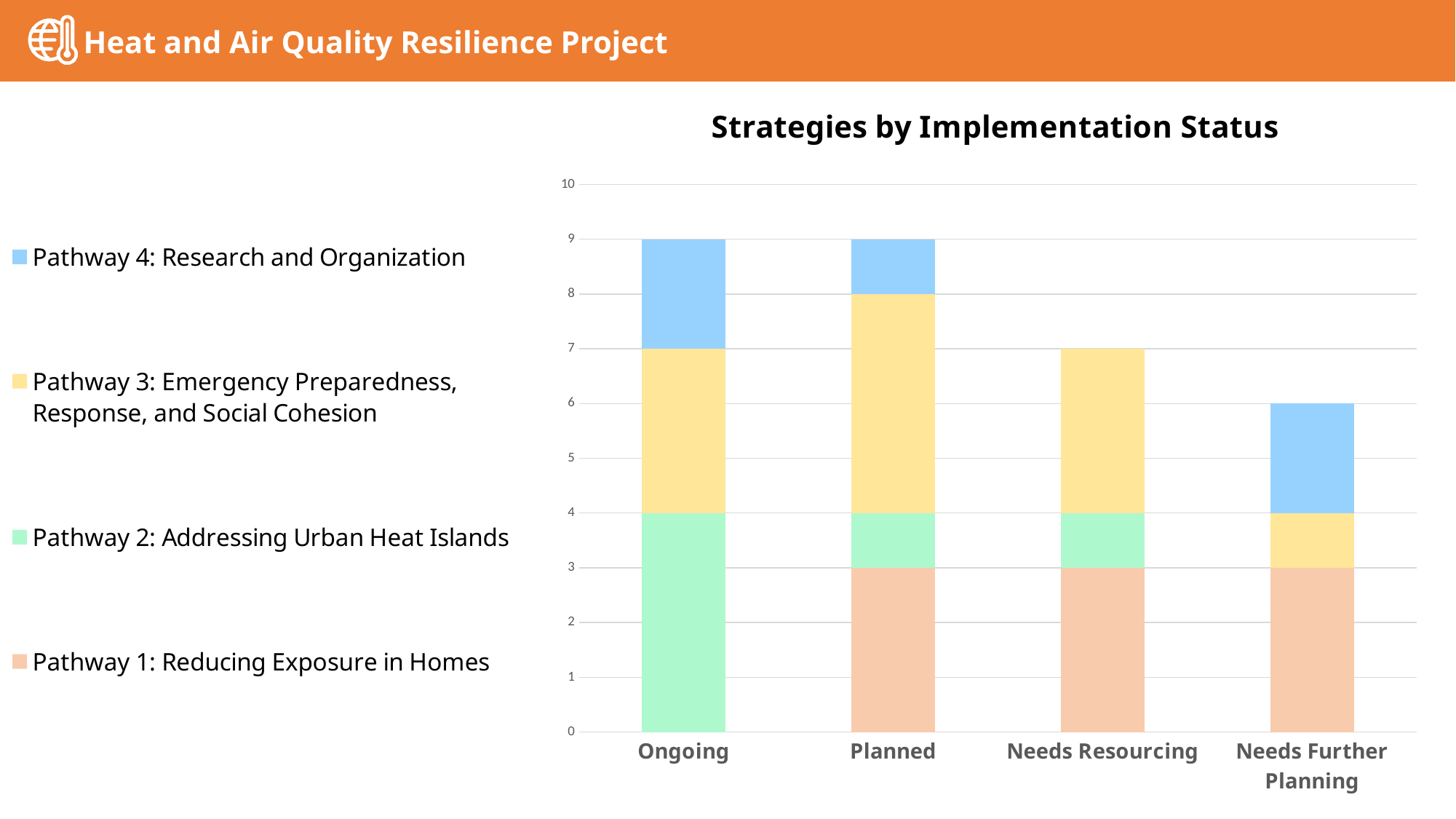
Which implementation status has the lowest total number of strategies? Needs Further Planning What is the total height of the Ongoing stacked bar? 9 Is the total for Needs Resourcing greater or less than 8? less What is the value for Pathway 2: Addressing Urban Heat Islands in the Ongoing category? 4 What kind of chart is shown on the slide? Stacked bar chart What is the total height of the Needs Resourcing stacked bar? 7 How many series does the legend list? 4 How many implementation status categories are shown on the x axis? 4 What is the value for Pathway 1: Reducing Exposure in Homes in the Planned category? 3 What is the total height of the Needs Further Planning stacked bar? 6 Which has a larger total, Needs Resourcing or Needs Further Planning? Needs Resourcing What is the title of the chart? Strategies by Implementation Status